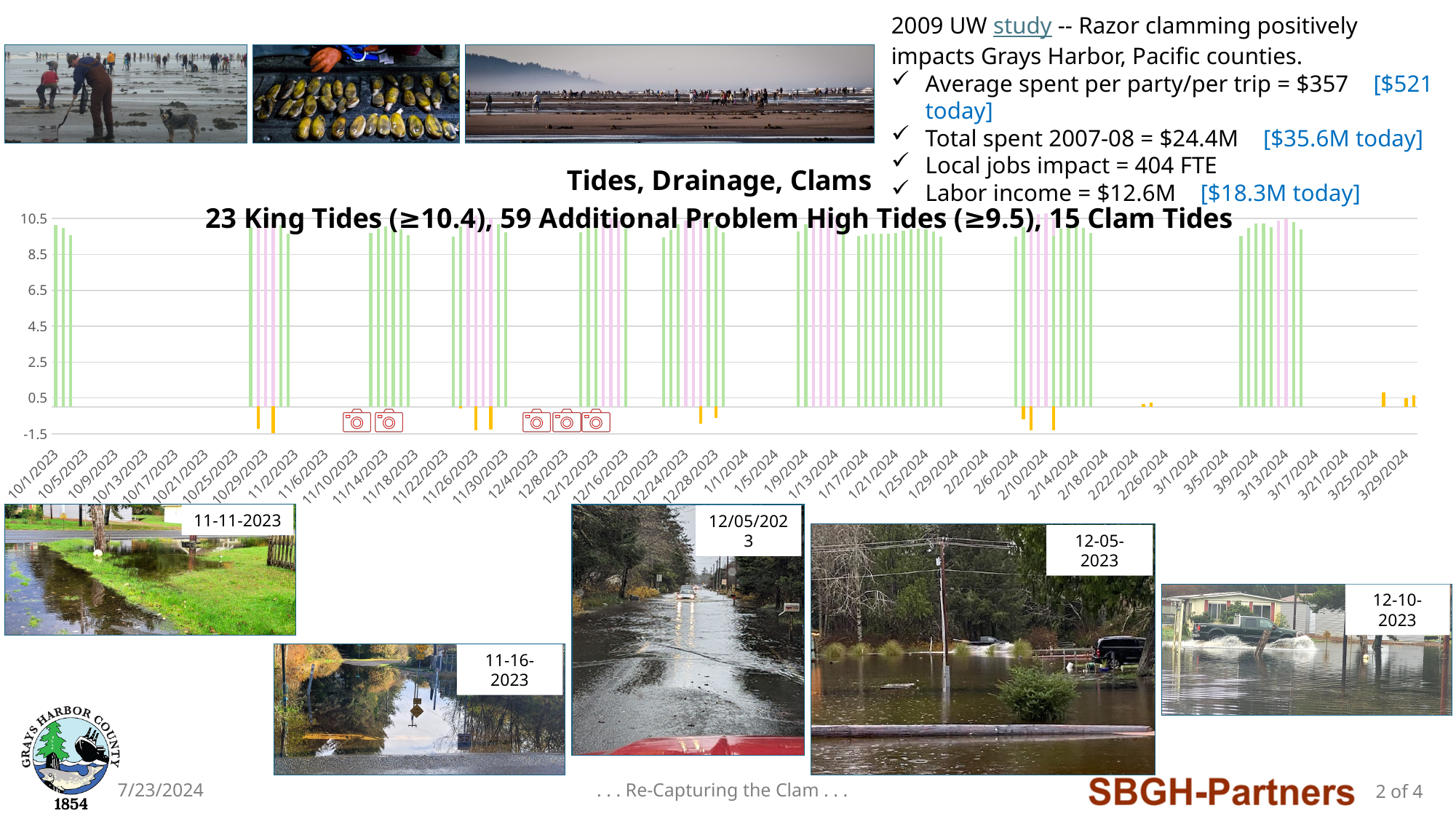
What kind of chart is shown on the slide? bar chart What is the last date label on the chart's horizontal axis? 3/29/2024 What is the title of the chart? Tides, Drainage, Clams Are the tall bars around 3/13/2024 greater or less than 4.5? greater Is the value of the orange bar just after 10/29/2023 greater or less than 0.5? less What is the lowest tick value shown on the chart's vertical axis? -1.5 Is the value of the tall bars around 1/9/2024 greater or less than 6.5? greater